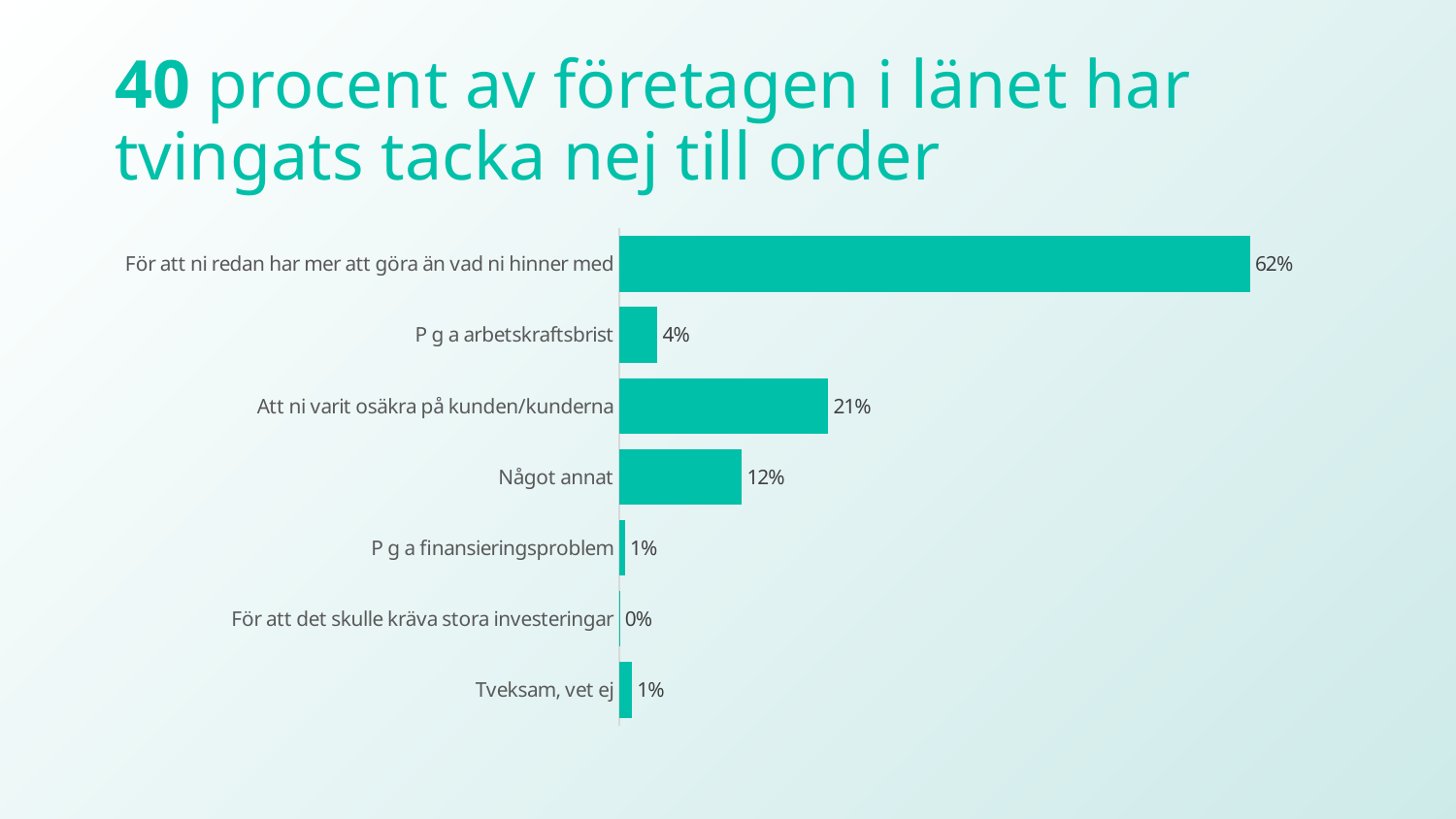
Which category has the lowest value? För att det skulle kräva stora investeringar What is the value for "Något annat"? 12% How many categories are shown in the chart? 7 What is the value for "För att det skulle kräva stora investeringar"? 0% What is the value for "Att ni varit osäkra på kunden/kunderna"? 21% What is the difference between the values for "Att ni varit osäkra på kunden/kunderna" and "Något annat"? 9% Which is larger: the value for "P g a arbetskraftsbrist" or the value for "Något annat"? Något annat What is the value for "P g a arbetskraftsbrist"? 4% Which category has the highest value? För att ni redan har mer att göra än vad ni hinner med What is the value for "För att ni redan har mer att göra än vad ni hinner med"? 62% What kind of chart is shown on the slide? Bar chart What is the title of the slide? 40 procent av företagen i länet har tvingats tacka nej till order